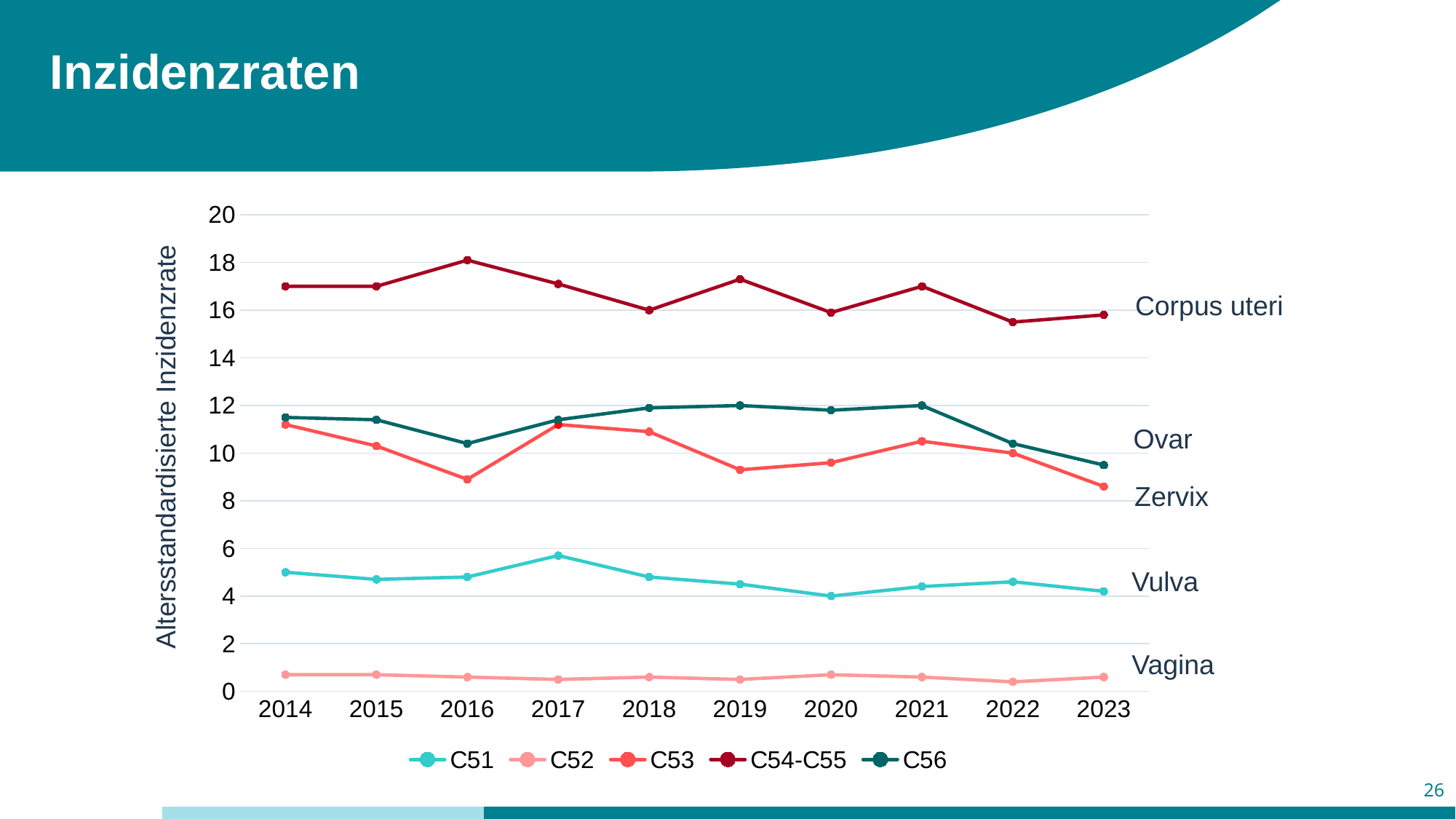
How many series does the legend list? 5 In 2019, which is larger, the value for C56 or the value for C53? C56 In which year does the C51 series reach its highest value? 2017 Which series has the highest values across all years? C54-C55 What kind of chart is shown on the slide? line chart Does the C54-C55 series rise or fall overall from 2014 to 2023? fall Is the value for C53 in 2016 greater or less than 10? less Which series has the lowest values across all years? C52 What is the label on the y axis? Altersstandardisierte Inzidenzrate In which year does the C54-C55 series reach its highest value? 2016 Is the value for C54-C55 in 2014 greater or less than 16? greater How many years are plotted along the x axis? 10